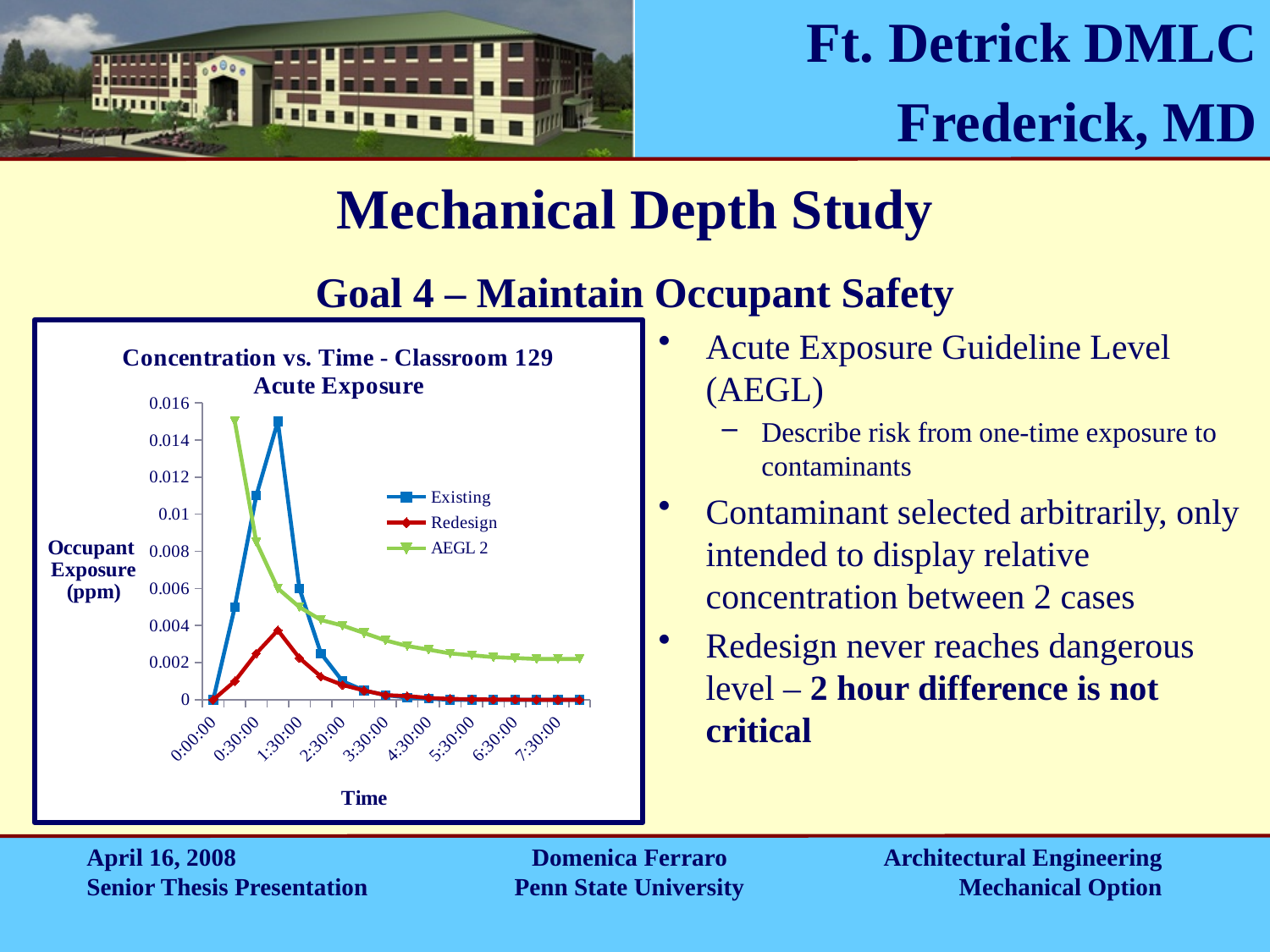
What is the title of the chart? Concentration vs. Time - Classroom 129 Acute Exposure How many time labels are shown on the x axis? 9 What is the label of the vertical axis of the chart? Occupant Exposure (ppm) Is the value of the AEGL 2 series at 7:30:00 greater or less than 0.004? less Is the peak value of the Existing series greater or less than 0.014? greater Does the AEGL 2 series rise or fall as time increases along the x axis? fall What kind of chart is shown on the slide? line chart Which series has the higher peak, Existing or Redesign? Existing What is the value of the Existing series at 0:00:00? 0 Which series reaches the lowest peak value? Redesign Is the peak value of the Redesign series greater or less than 0.006? less How many series does the chart legend list? 3